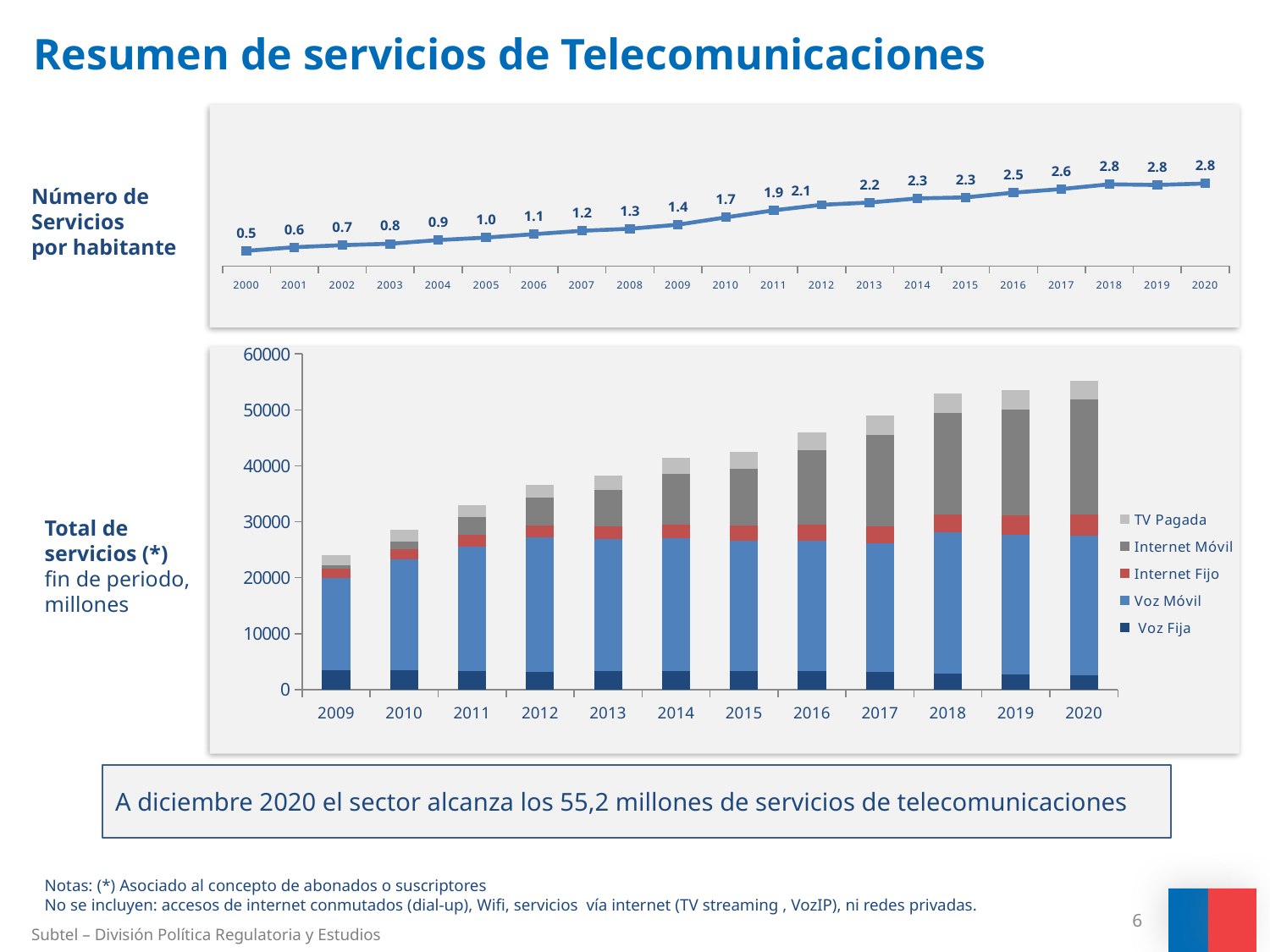
In the top chart (Número de Servicios por habitante), how many years are plotted? 21 In the bottom chart (Total de servicios), is the total stacked value for 2020 greater or less than 50000? greater In the top chart (Número de Servicios por habitante), what is the value for 2020? 2.8 In the bottom chart (Total de servicios), how many series does the legend list? 5 In the top chart (Número de Servicios por habitante), do the values generally rise or fall from 2000 to 2020? Rise In the top chart (Número de Servicios por habitante), is the value for 2010 larger than the value for 2009? Yes, 2010 (1.7) is larger than 2009 (1.4) In the top chart (Número de Servicios por habitante), what is the value for 2000? 0.5 In the top chart (Número de Servicios por habitante), what is the difference between the values for 2020 and 2000? 2.3 In the top chart (Número de Servicios por habitante), which year has the lowest value? 2000 In the top chart (Número de Servicios por habitante), what is the value for 2012? 2.1 What kind of chart is the bottom chart (Total de servicios)? Stacked bar chart In the bottom chart (Total de servicios), is the total stacked value for 2009 greater or less than 30000? less